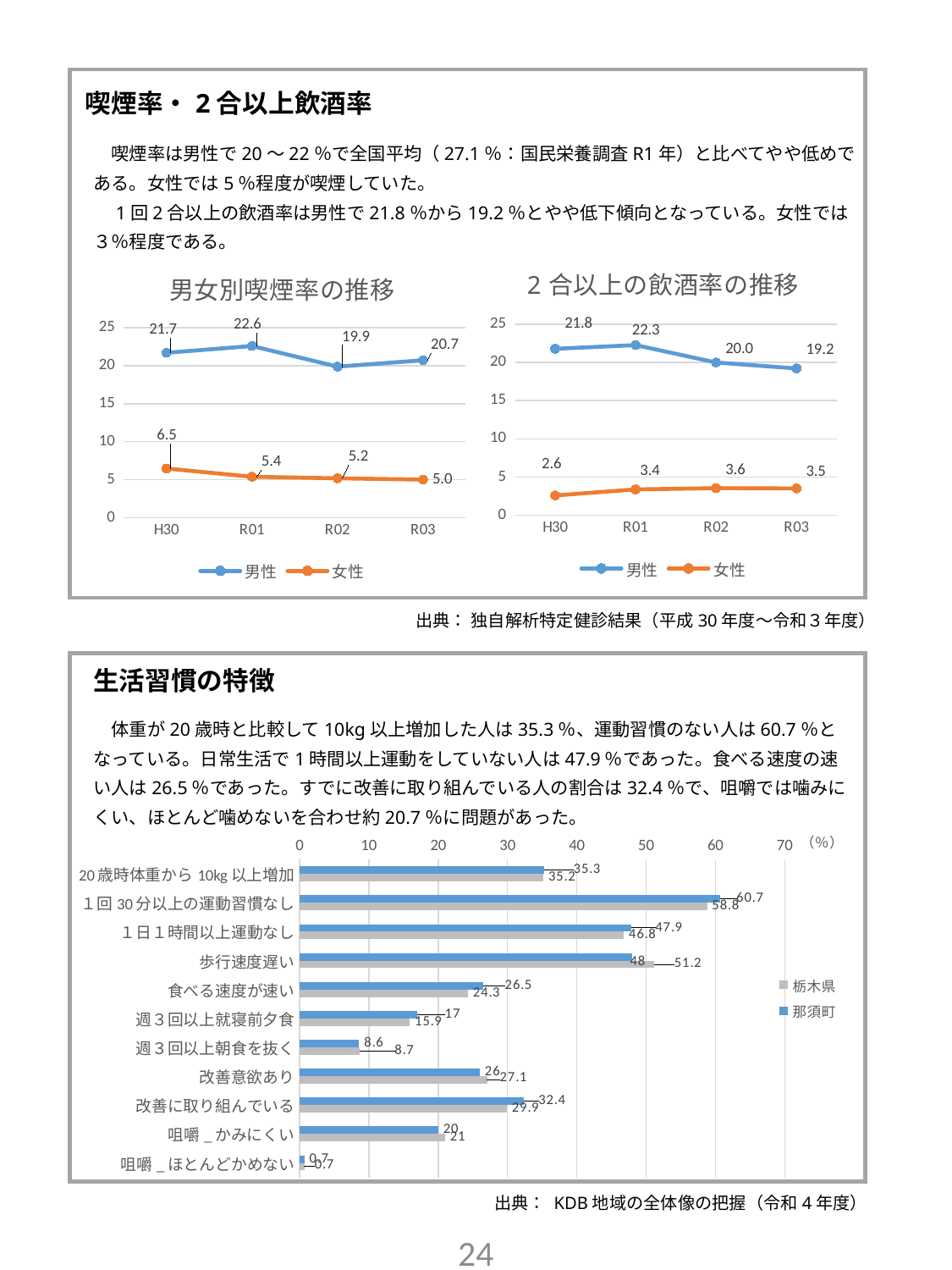
In the 2合以上の飲酒率の推移 chart, in which year is the 女性 value highest? R02 In the 男女別喫煙率の推移 chart, what is the value for 男性 in R01? 22.6 In the bottom bar chart, what is the value for 那須町 for 1回30分以上の運動習慣なし? 60.7 In the bottom bar chart, which is larger for 改善に取り組んでいる, 那須町 or 栃木県? 那須町 In the 男女別喫煙率の推移 chart, in which year is the 男性 value lowest? R02 In the 男女別喫煙率の推移 chart, what is the difference between the 男性 and 女性 values in R03? 15.7 In the 男女別喫煙率の推移 chart, what is the value for 女性 in H30? 6.5 How many series does the legend of the 2合以上の飲酒率の推移 chart list? 2 In the 2合以上の飲酒率の推移 chart, what is the value for 男性 in R03? 19.2 In the 2合以上の飲酒率の推移 chart, does the 男性 value rise or fall from R01 to R03? fall In the bottom bar chart, what is the value for 栃木県 for 歩行速度遅い? 51.2 What kind of chart is the bottom chart on the slide? bar chart